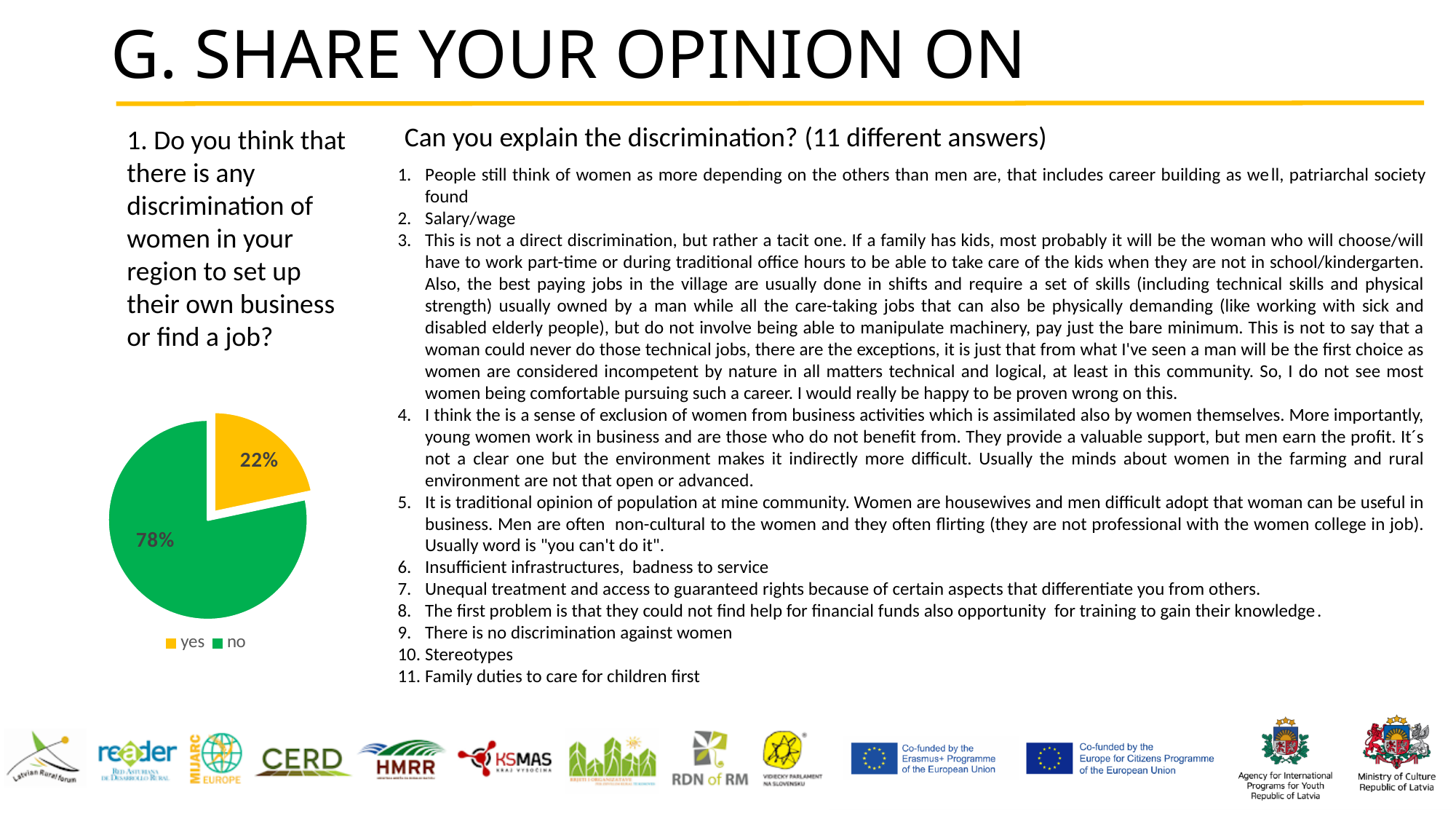
What colour is the "no" slice? green How many slices does the pie chart have? 2 What kind of chart is shown on the slide? pie chart What percentage of respondents answered "yes"? 22% Which answer has the largest share of the pie? no What colour is the "yes" slice? yellow How many entries does the legend list? 2 What is the difference in percentage points between the "no" and "yes" shares? 56 Which is larger, the share for "yes" or the share for "no"? no Which answer has the smallest share of the pie? yes What percentage of respondents answered "no"? 78%